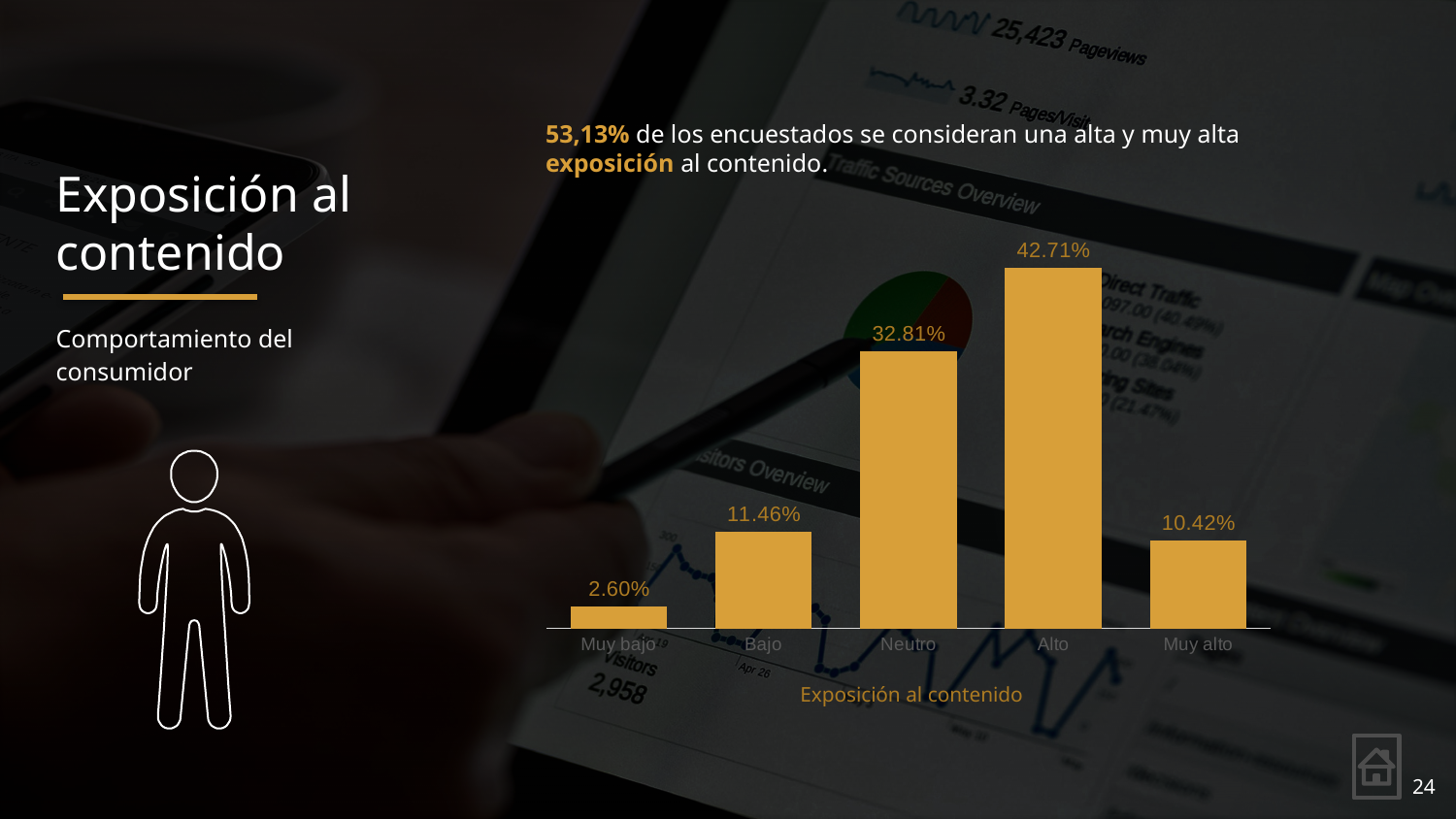
What is the difference between the values for Alto and Neutro? 9.90% What is the value for Muy bajo? 2.60% Which category has the highest value? Alto Which is larger, the value for Bajo or the value for Muy alto? Bajo What is the combined value of Alto and Muy alto? 53.13% What is the title shown below the chart's x axis? Exposición al contenido What kind of chart is shown on the slide? Bar chart Which category has the lowest value? Muy bajo What is the value for Neutro? 32.81% What is the value for Alto? 42.71% What is the value for Muy alto? 10.42% How many categories are shown on the x axis? 5